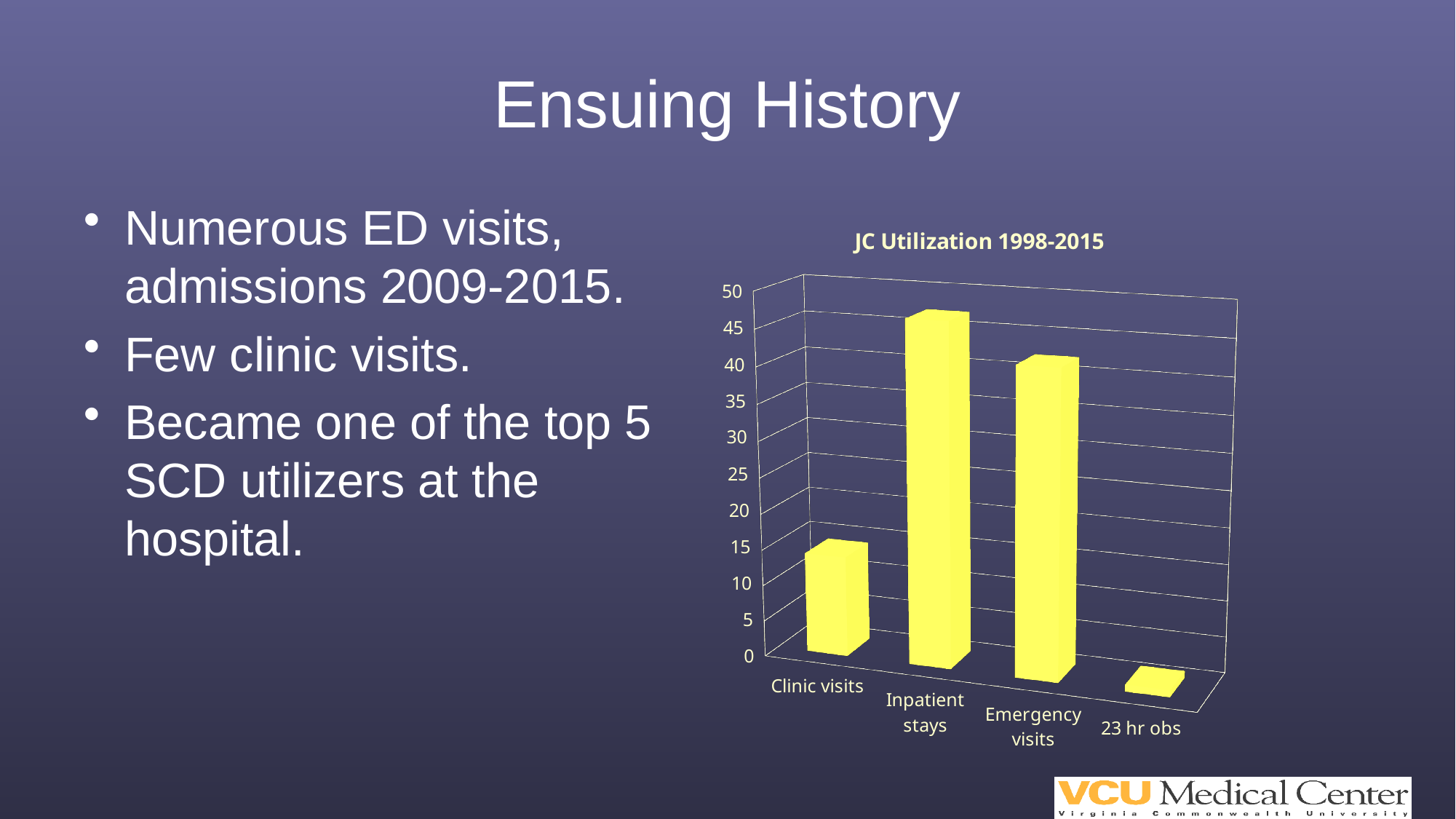
Which category has the highest bar? Inpatient stays What colour are the bars in the chart? yellow Is the value for Emergency visits greater or less than 30? greater Is the value for 23 hr obs greater or less than 5? less Which is larger, the value for Inpatient stays or the value for Emergency visits? Inpatient stays How many categories are shown on the chart's x axis? 4 What is the title of the chart? JC Utilization 1998-2015 Is the value for Clinic visits greater or less than 20? less Which is larger, the value for Clinic visits or the value for Emergency visits? Emergency visits Which category has the lowest bar? 23 hr obs What kind of chart is shown on the slide? bar chart